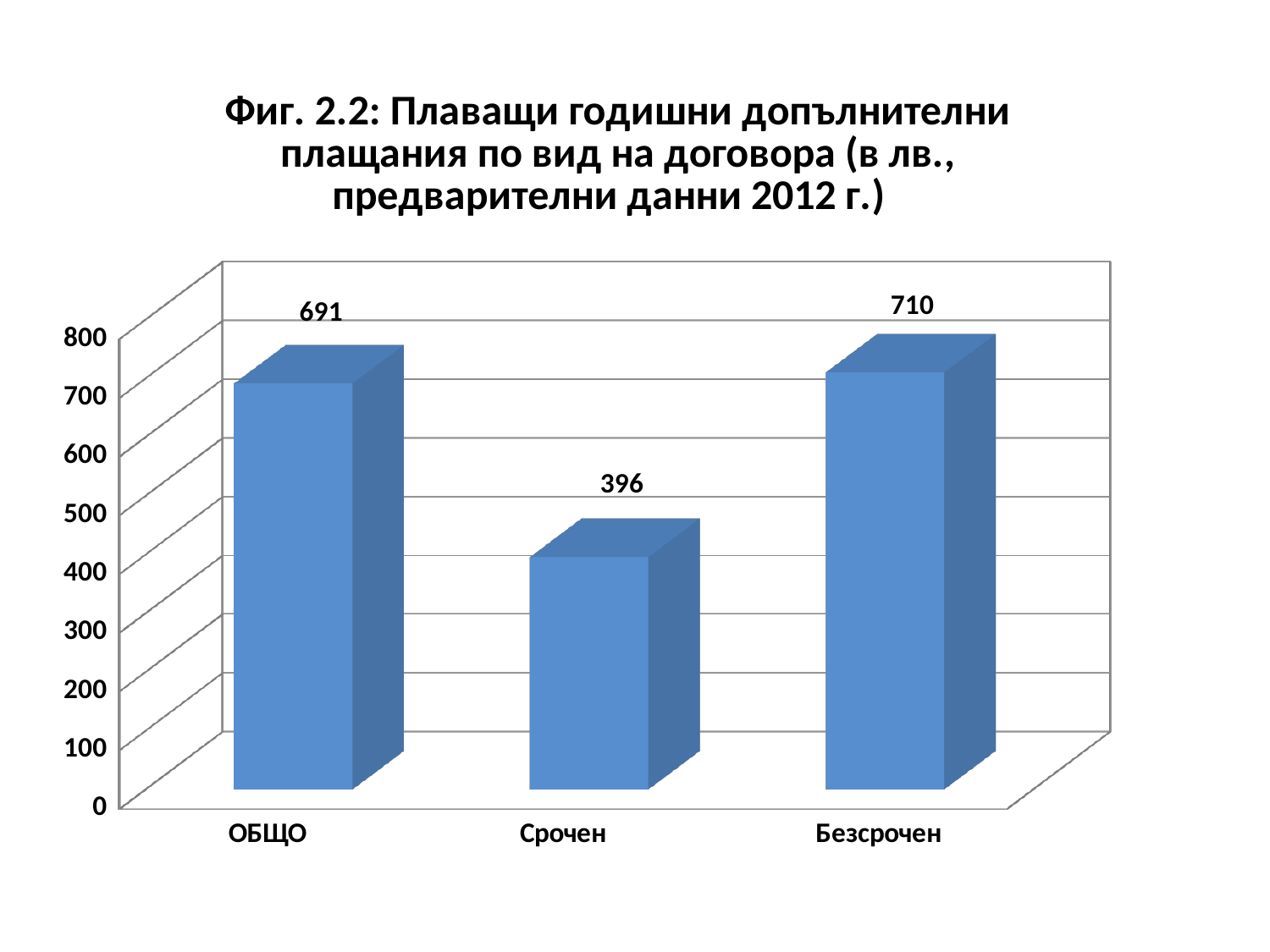
What is the value for Безсрочен? 710 What is the figure number given in the chart title? Фиг. 2.2 Is the value for Срочен greater or less than 500? less Which is larger, the value for ОБЩО or the value for Срочен? ОБЩО What is the difference between the values for ОБЩО and Срочен? 295 Which category has the highest value? Безсрочен What is the value for ОБЩО? 691 What is the value for Срочен? 396 What is the difference between the values for Безсрочен and Срочен? 314 What kind of chart is shown on the slide? bar chart Which category has the lowest value? Срочен How many categories are shown on the x axis? 3